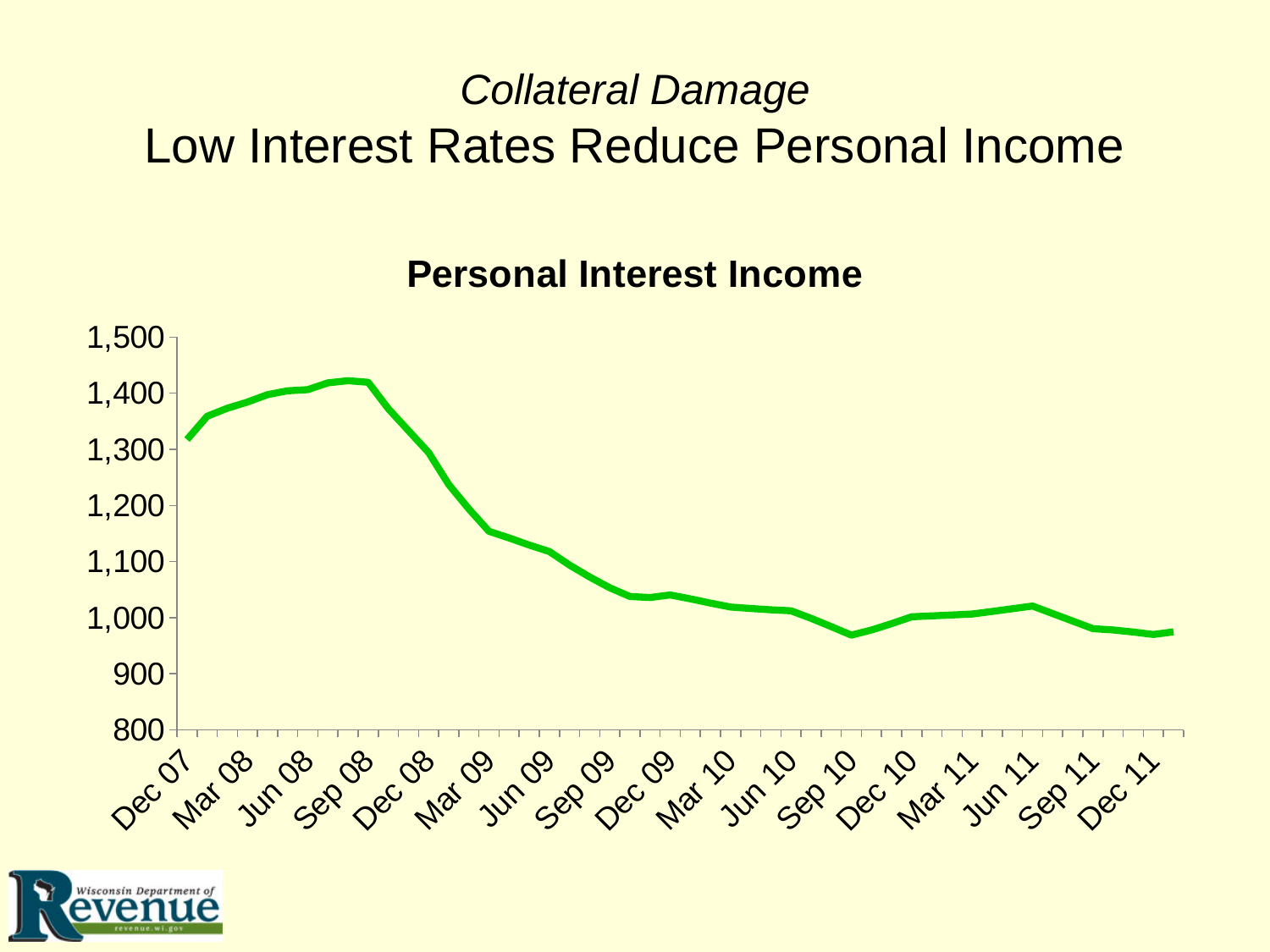
Is the value for Mar 09 greater or less than 1,200? less Is the value for Sep 10 greater or less than 1,000? less Which is larger, the value for Dec 07 or the value for Dec 11? Dec 07 Is the value for Sep 08 greater or less than 1,400? greater Overall, does Personal Interest Income rise or fall from Dec 07 to Dec 11? fall What is the title of the chart? Personal Interest Income At which labelled date does Personal Interest Income reach its highest value? Sep 08 What colour is the line in the chart? green What kind of chart is shown on the slide? line chart